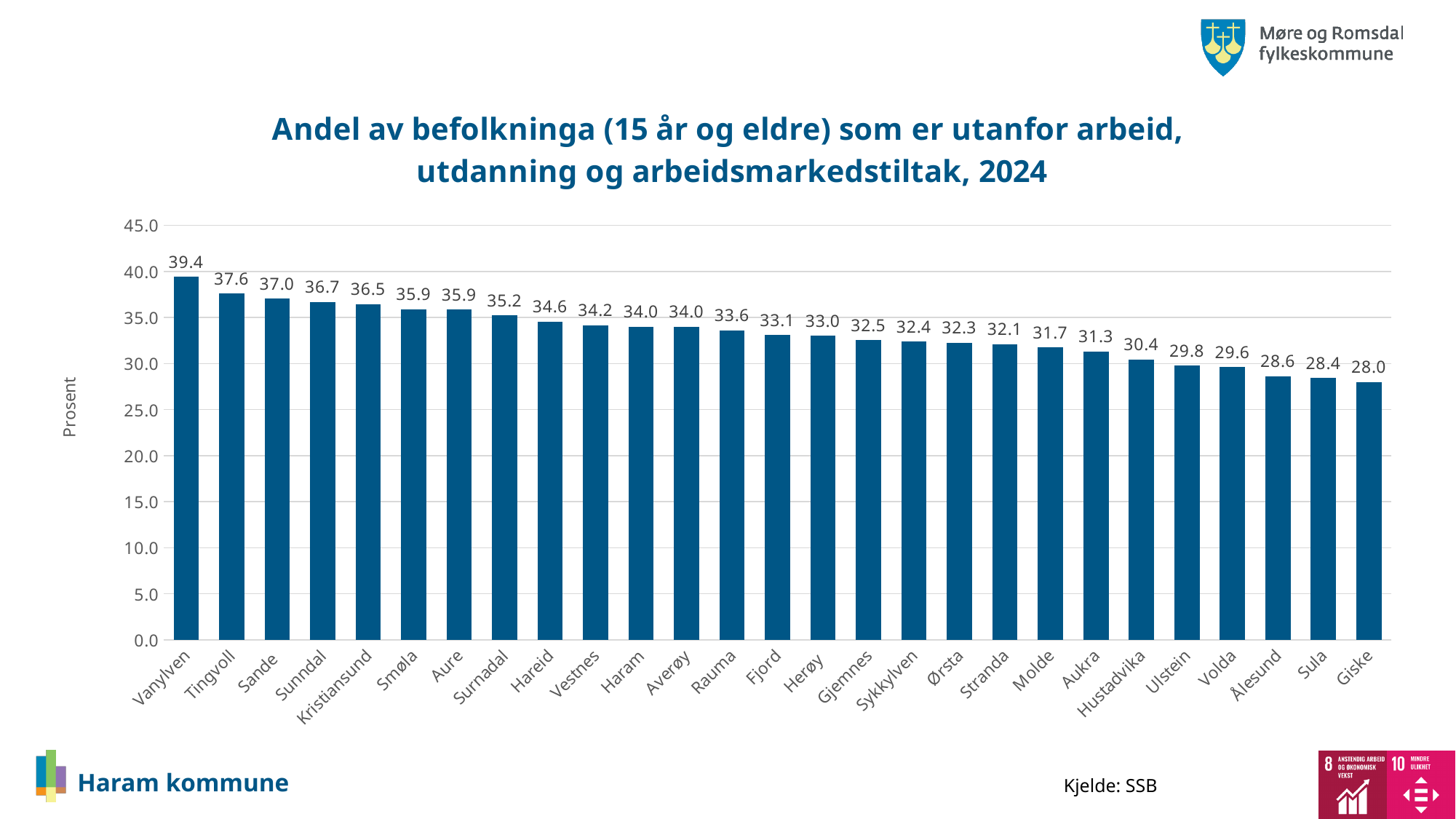
Which municipality has the highest value? Vanylven How many municipalities are shown on the chart? 27 What is the value for Molde? 31.7 What is the label of the vertical axis? Prosent Which has a larger value, Sunndal or Hustadvika? Sunndal Is the value for Ulstein greater or less than 30.0? less What is the value for Haram? 34.0 What is the difference between the values for Vanylven and Giske? 11.4 What is the difference between the values for Tingvoll and Ålesund? 9.0 Which municipality has the lowest value? Giske What kind of chart is shown on the slide? bar chart What is the value for Kristiansund? 36.5